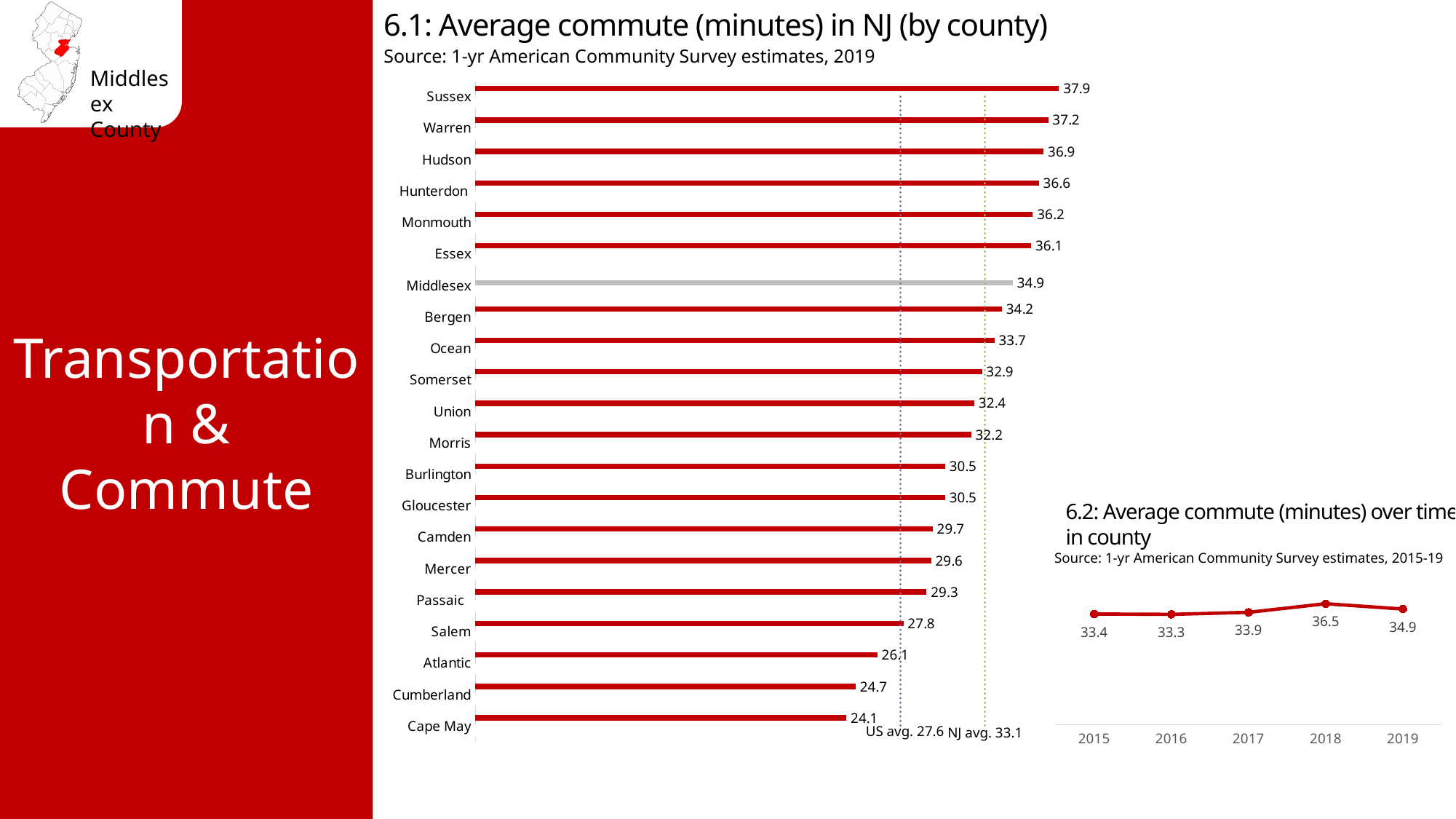
In chart 6.1 (Average commute in NJ by county), what NJ average is marked by the dotted reference line? 33.1 In chart 6.1 (Average commute in NJ by county), what is the average commute for Middlesex? 34.9 In chart 6.2 (Average commute over time in county), how many years are plotted? 5 In chart 6.1 (Average commute in NJ by county), what is the difference between the average commute for Sussex and Cape May? 13.8 In chart 6.1 (Average commute in NJ by county), how many counties are shown? 21 In chart 6.1 (Average commute in NJ by county), which county has the highest average commute? Sussex In chart 6.1 (Average commute in NJ by county), what is the average commute for Atlantic? 26.1 What kind of chart is chart 6.2 (Average commute over time in county)? Line chart In chart 6.2 (Average commute over time in county), what was the average commute in 2018? 36.5 In chart 6.2 (Average commute over time in county), which year had the highest average commute? 2018 In chart 6.1 (Average commute in NJ by county), which county has the lowest average commute? Cape May In chart 6.1 (Average commute in NJ by county), which has a longer average commute, Hudson or Bergen? Hudson